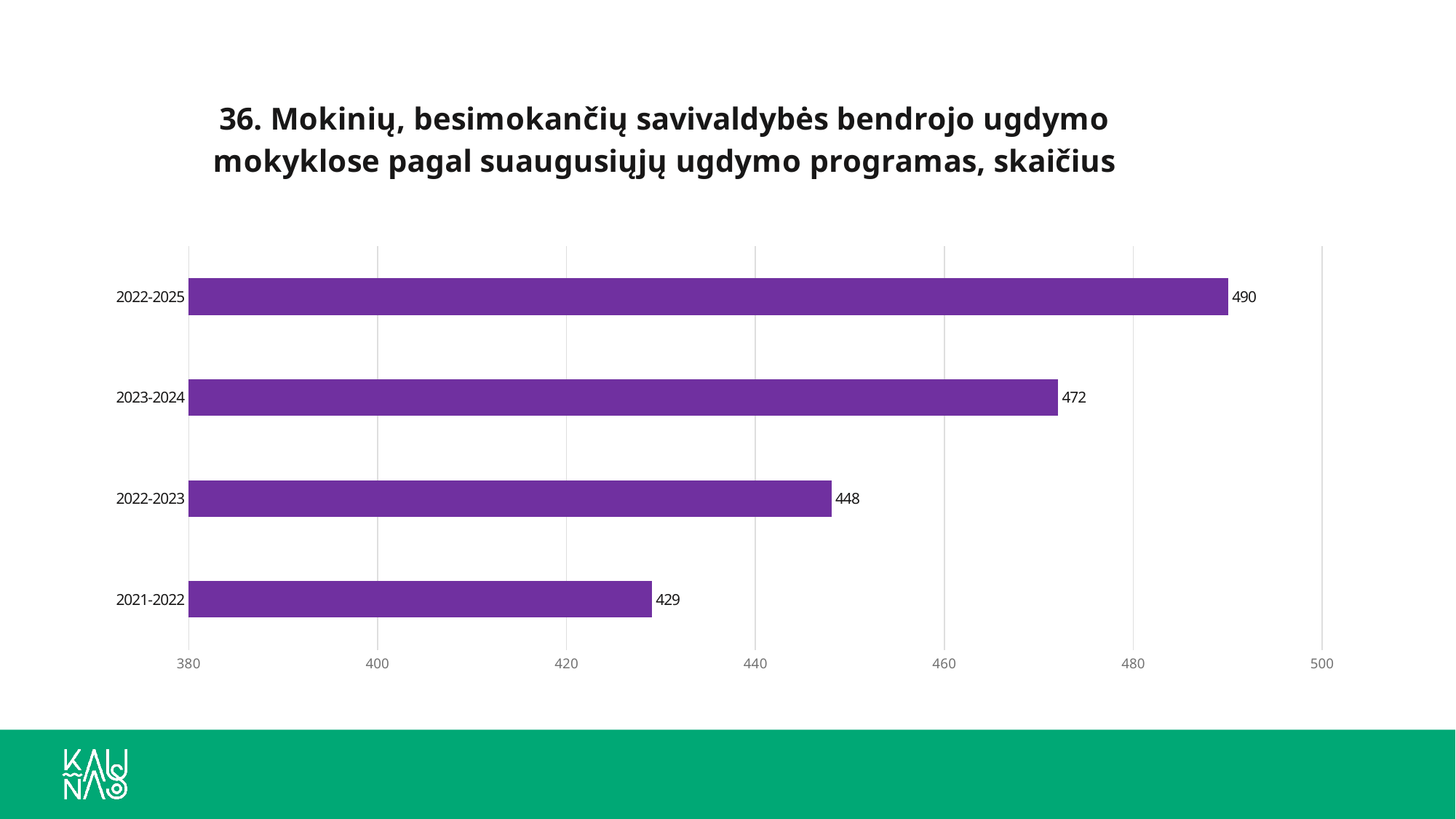
Which category has the lowest value? 2021-2022 Which category has the highest value? 2022-2025 What is the difference between the values for 2023-2024 and 2022-2023? 24 Which is larger, the value for 2023-2024 or the value for 2022-2023? 2023-2024 Is the value for 2022-2023 greater or less than 440? greater What is the value for 2022-2023? 448 How many categories are shown in the chart? 4 What is the difference between the values for 2022-2025 and 2021-2022? 61 What is the value for 2021-2022? 429 What is the value for 2022-2025? 490 What kind of chart is shown on the slide? bar chart What colour are the bars in the chart? purple